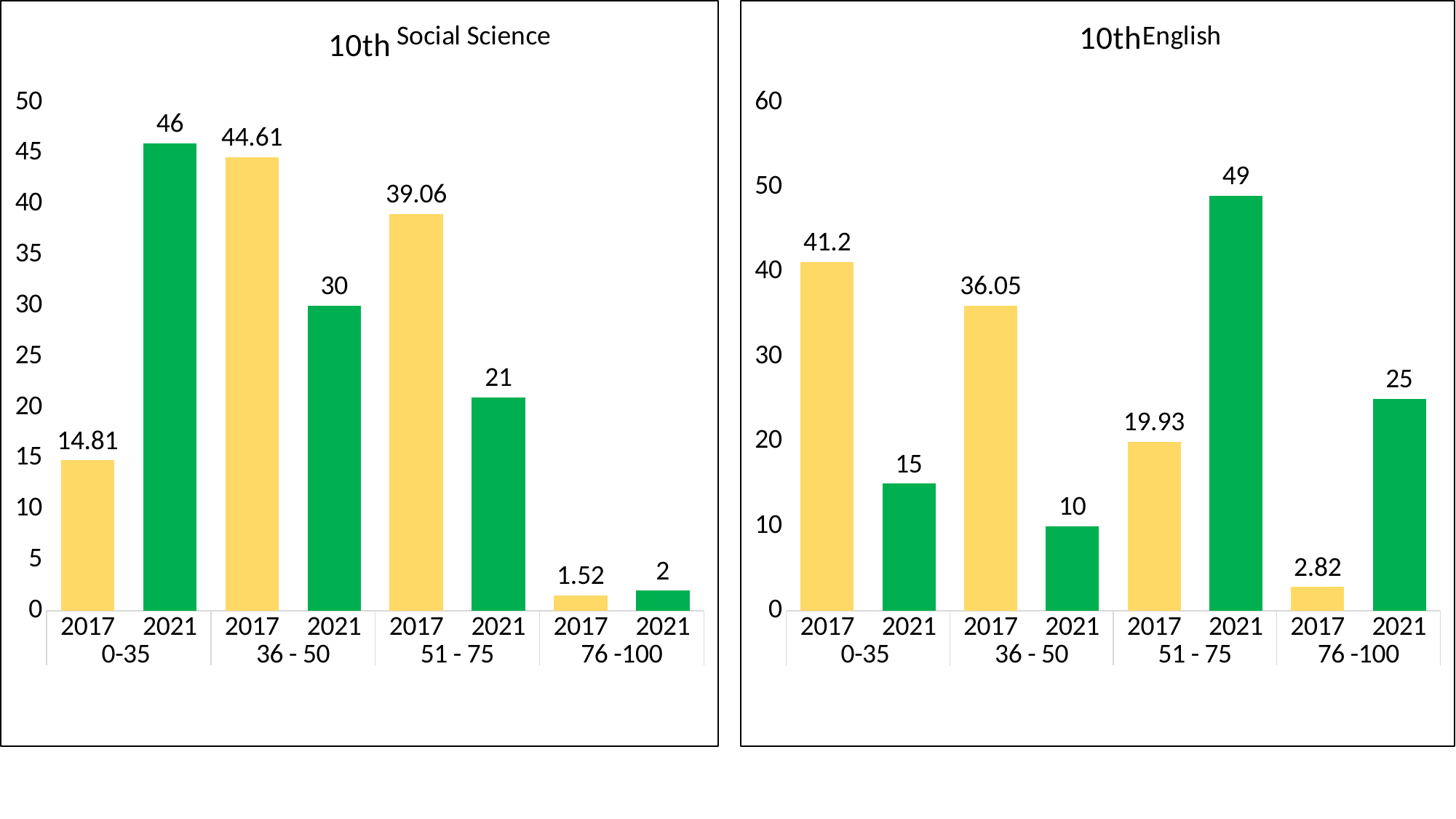
In the 10th Social Science chart, how many bars are plotted? 8 In the 10th Social Science chart, what is the value for 2021 in the 0-35 range? 46 In the 10th Social Science chart, which bar has the lowest value? 2017 in 76 -100 What type of chart is the 10th English chart? Bar chart In the 10th Social Science chart, what colour are the 2021 bars? Green In the 10th English chart, which bar has the highest value? 2021 in 51 - 75 In the 10th English chart, what is the value for 2021 in the 36 - 50 range? 10 In the 10th English chart, which is larger: the 2017 value or the 2021 value in the 0-35 range? 2017 In the 10th Social Science chart, what is the value for 2017 in the 51 - 75 range? 39.06 In the 10th Social Science chart, what is the difference between the 2017 and 2021 values in the 36 - 50 range? 14.61 In the 10th English chart, what is the value for 2017 in the 36 - 50 range? 36.05 In the 10th English chart, what is the difference between the 2021 and 2017 values in the 76 -100 range? 22.18